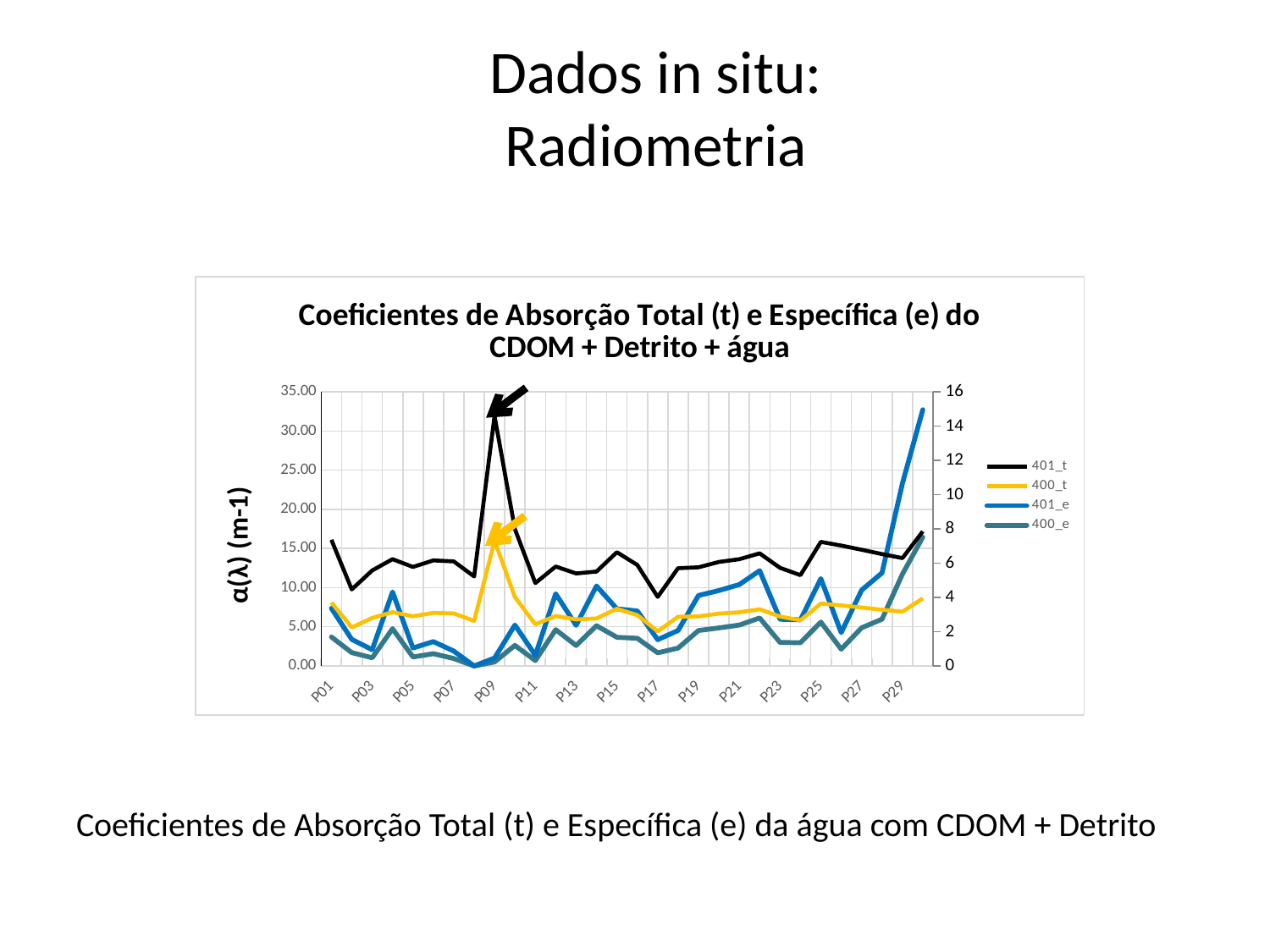
Is the value of the 401_t series at P09 greater or less than 30.00 on the left axis? greater How many category labels are printed along the x axis? 15 At which x-axis point does the 400_t series reach its highest value? P09 How many series does the legend list? 4 Is the value of the 400_t series at P01 greater or less than 10.00 on the left axis? less What kind of chart is shown on the slide? line chart At which x-axis point does the 401_t series reach its highest value? P09 Which series has the higher value at P09, 401_t or 400_t? 401_t What is the title of the chart? Coeficientes de Absorção Total (t) e Específica (e) do CDOM + Detrito + água Is the value of the 401_t series at P17 greater or less than 10.00 on the left axis? less Is the value of the 401_t series larger at P09 or at P01? P09 What are the series names listed in the legend? 401_t, 400_t, 401_e, 400_e